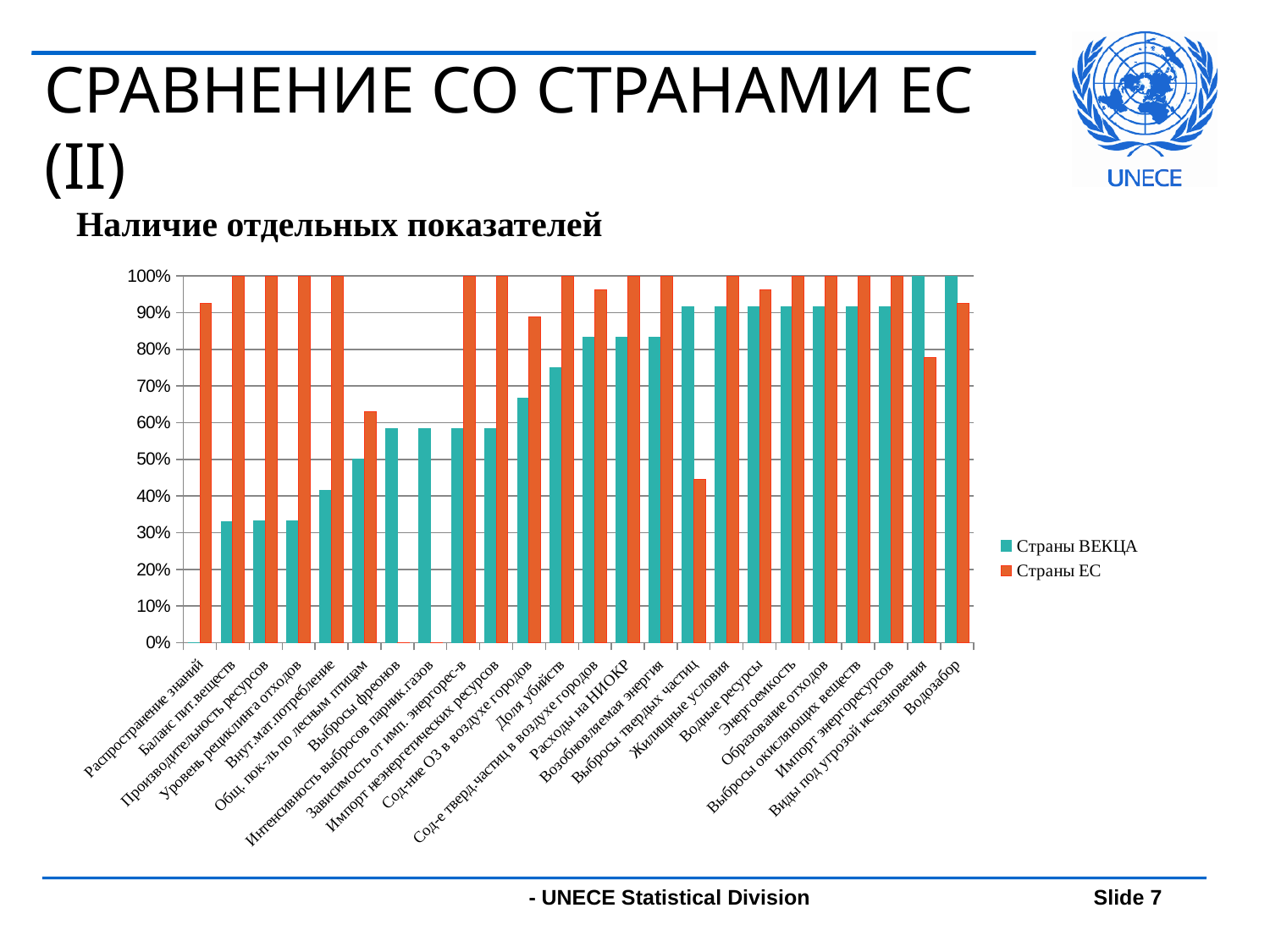
Is the value for Страны ЕС in the category Распространение знаний greater or less than 90%? greater How many categories are shown on the x axis of the chart? 24 What is the value for Страны ВЕКЦА in the category Водозабор? 100% How many series does the legend list? 2 What kind of chart is shown on the slide? bar chart Is the value for Страны ЕС in the category Жилищные условия greater or less than 50%? greater In the category Виды под угрозой исчезновения, which series has the larger value, Страны ВЕКЦА or Страны ЕС? Страны ВЕКЦА What is the value for Страны ЕС in the category Баланс пит.веществ? 100% Is the value for Страны ВЕКЦА in the category Баланс пит.веществ greater or less than 40%? less Which series is shown in orange in the chart? Страны ЕС In the category Жилищные условия, which series has the larger value, Страны ВЕКЦА or Страны ЕС? Страны ЕС